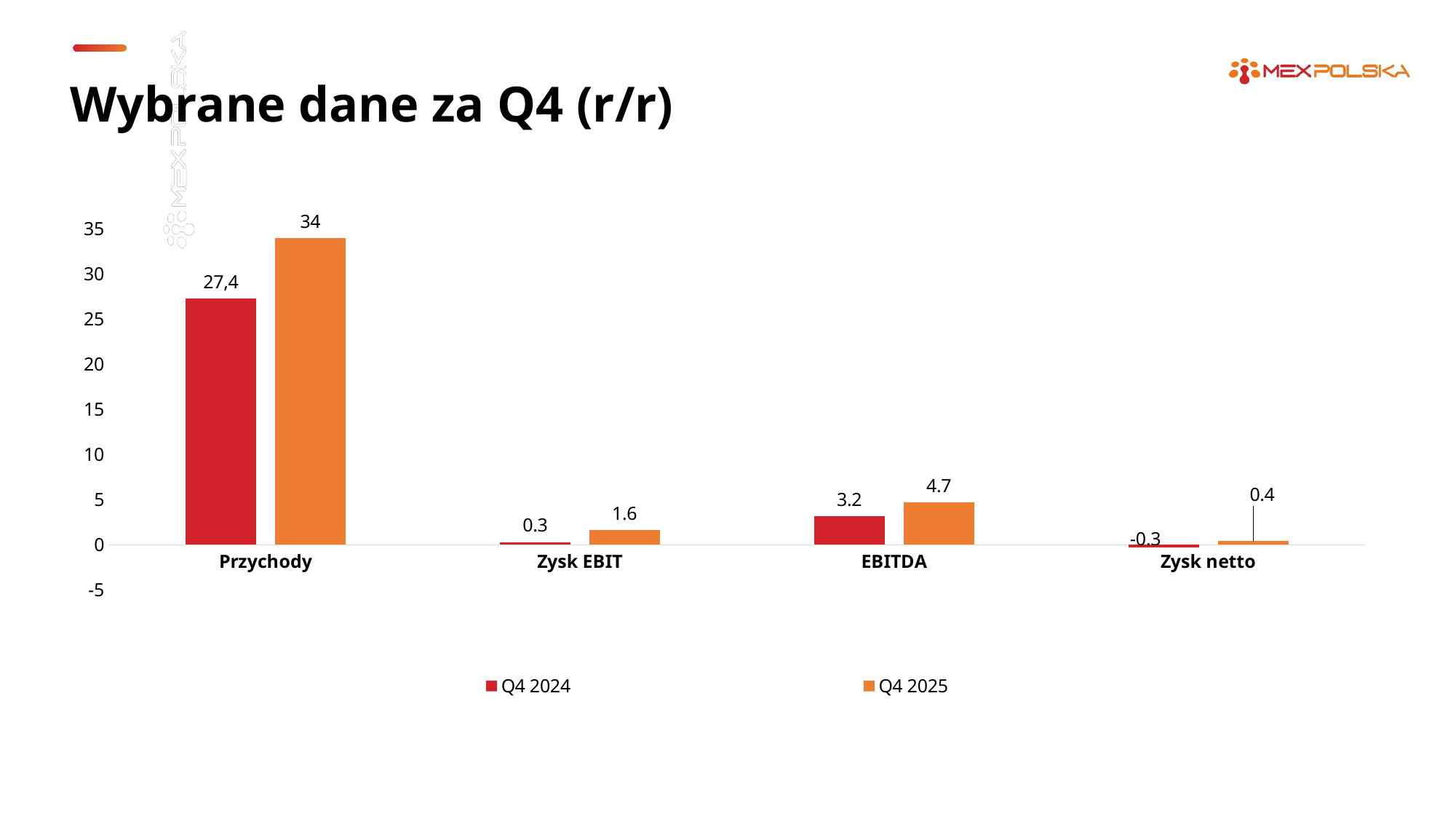
What is the difference between the Q4 2025 and Q4 2024 values for EBITDA? 1.5 Which category has the lowest Q4 2024 value? Zysk netto Which category has the highest Q4 2025 value? Przychody What is the Q4 2024 value for Przychody? 27,4 What is the Q4 2024 value for Zysk netto? -0.3 What is the Q4 2025 value for Zysk EBIT? 1.6 How many series does the legend list? 2 How many categories are shown on the x axis? 4 Which is larger for EBITDA: the Q4 2024 value or the Q4 2025 value? Q4 2025 What is the Q4 2025 value for Przychody? 34 What is the Q4 2025 value for EBITDA? 4.7 What is the difference between the Q4 2025 and Q4 2024 values for Zysk EBIT? 1.3